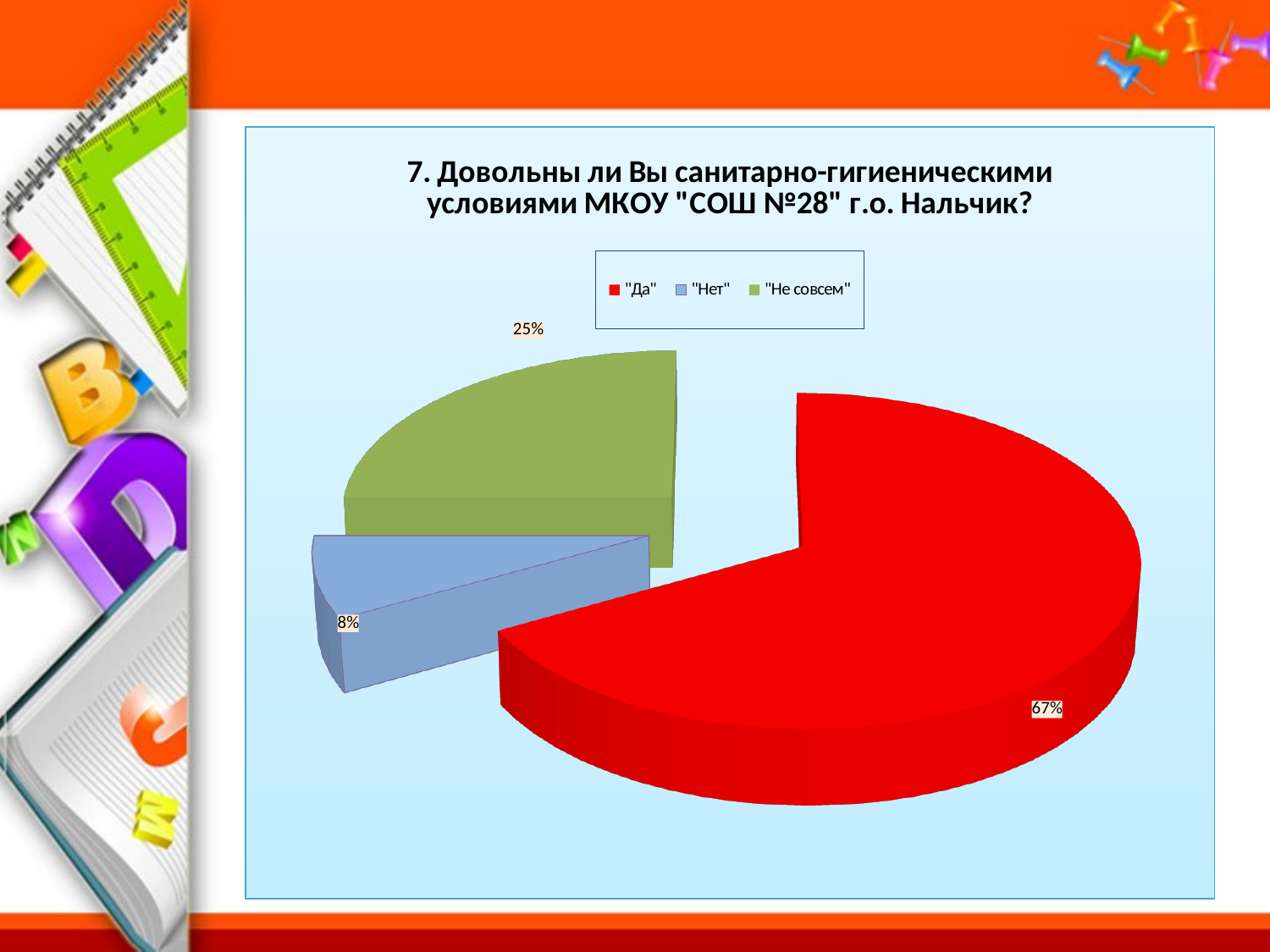
How many entries does the legend list? 3 What is the difference in percentage points between "Да" and "Не совсем"? 42 Which answer has the smallest share of the pie? "Нет" What colour is the slice for "Не совсем"? green What percentage of respondents answered "Не совсем"? 25% How many slices does the pie chart have? 3 Which answer has the largest share of the pie? "Да" What percentage of respondents answered "Да"? 67% What percentage of respondents answered "Нет"? 8% Which is larger: the share for "Нет" or the share for "Не совсем"? "Не совсем" What kind of chart is shown on the slide? pie chart What is the difference in percentage points between "Не совсем" and "Нет"? 17